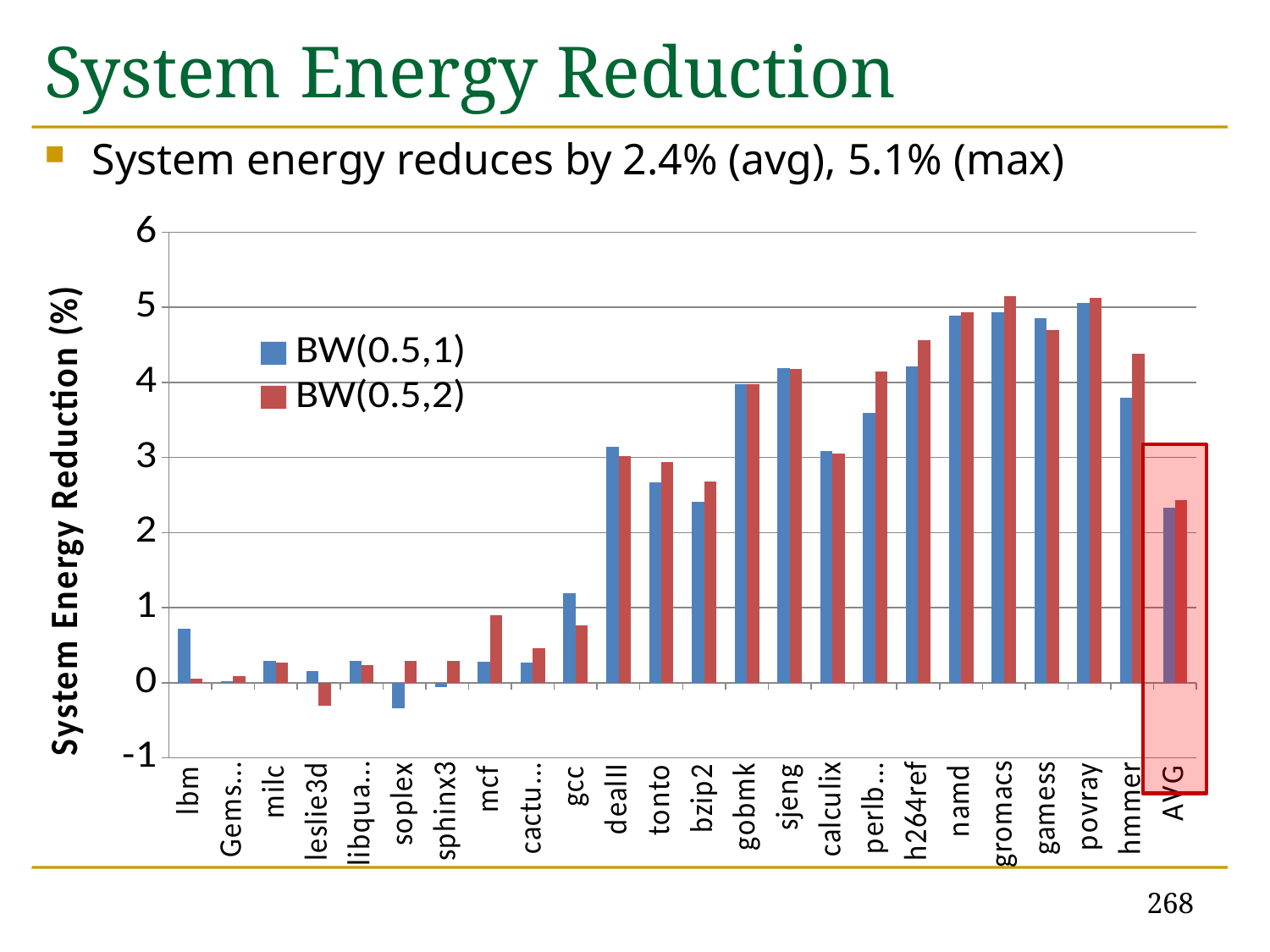
Which category has the lowest BW(0.5,1) value? soplex How many series does the legend list? 2 For gcc, which series has the larger value, BW(0.5,1) or BW(0.5,2)? BW(0.5,1) What kind of chart is shown on the slide? bar chart Is the BW(0.5,1) value for AVG greater or less than 2? greater Do the values generally rise or fall moving from lbm on the left toward hmmer on the right? rise Which category has the lowest BW(0.5,2) value? leslie3d Is the BW(0.5,1) value for tonto greater or less than 3? less For hmmer, which series has the larger value, BW(0.5,1) or BW(0.5,2)? BW(0.5,2) Is the BW(0.5,2) value for h264ref greater or less than 4? greater How many categories are shown along the x axis? 24 What is the title of the y axis? System Energy Reduction (%)